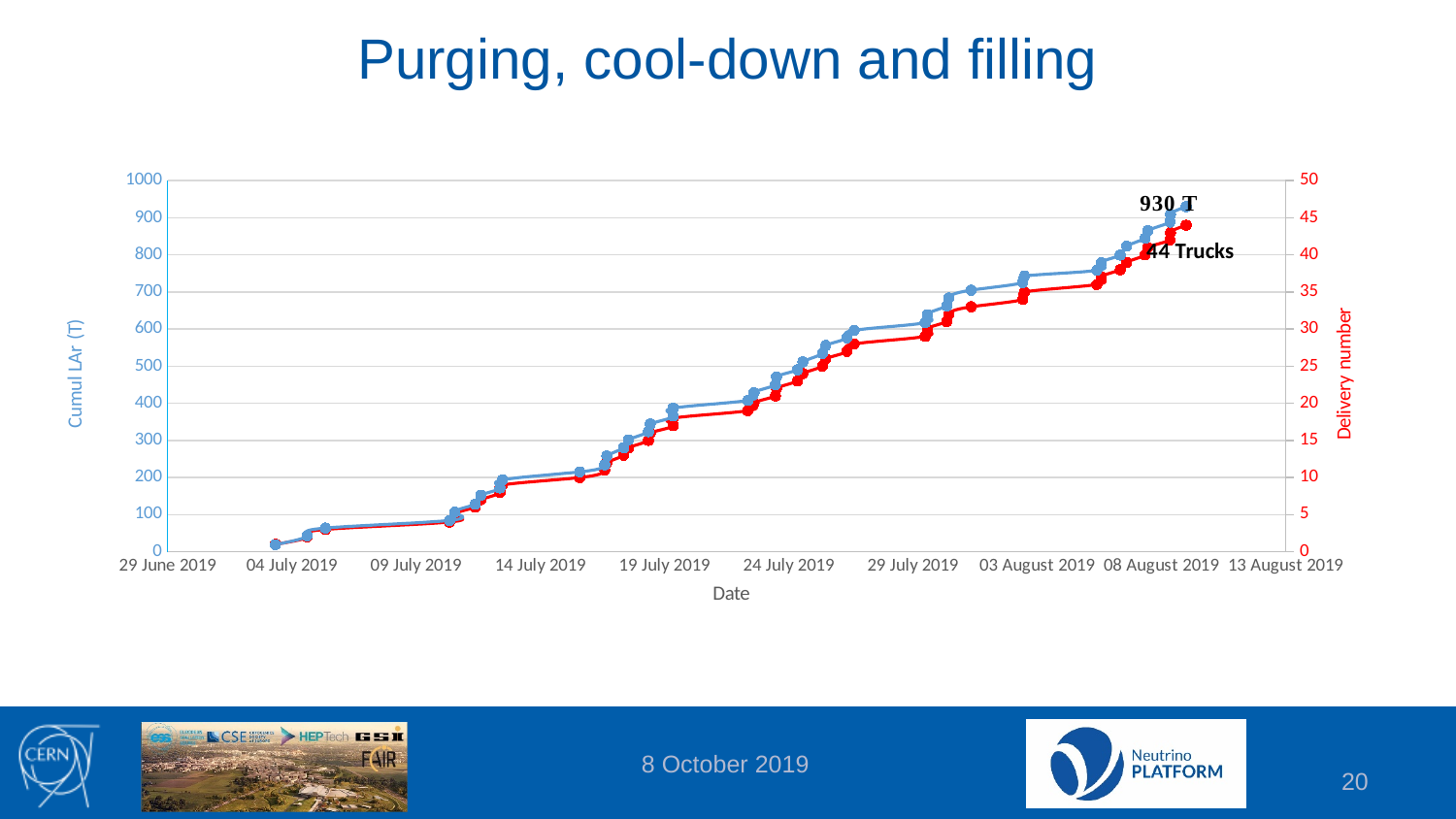
What final cumulative LAr value is annotated at the end of the blue line? 930 T Is the cumulative LAr value on 29 July 2019 greater or less than 500? greater Is the cumulative LAr value on 04 July 2019 greater or less than 100? less Does the cumulative LAr rise or fall over the dates shown on the x axis? rise Is the delivery number on 03 August 2019 greater or less than 30? greater What is the label of the right vertical axis? Delivery number What kind of chart is shown on the slide? line chart What is the label of the left vertical axis? Cumul LAr (T) Is the cumulative LAr higher on 29 July 2019 or on 14 July 2019? 29 July 2019 How many trucks does the annotation on the chart report? 44 Trucks How many data series are plotted on the chart? 2